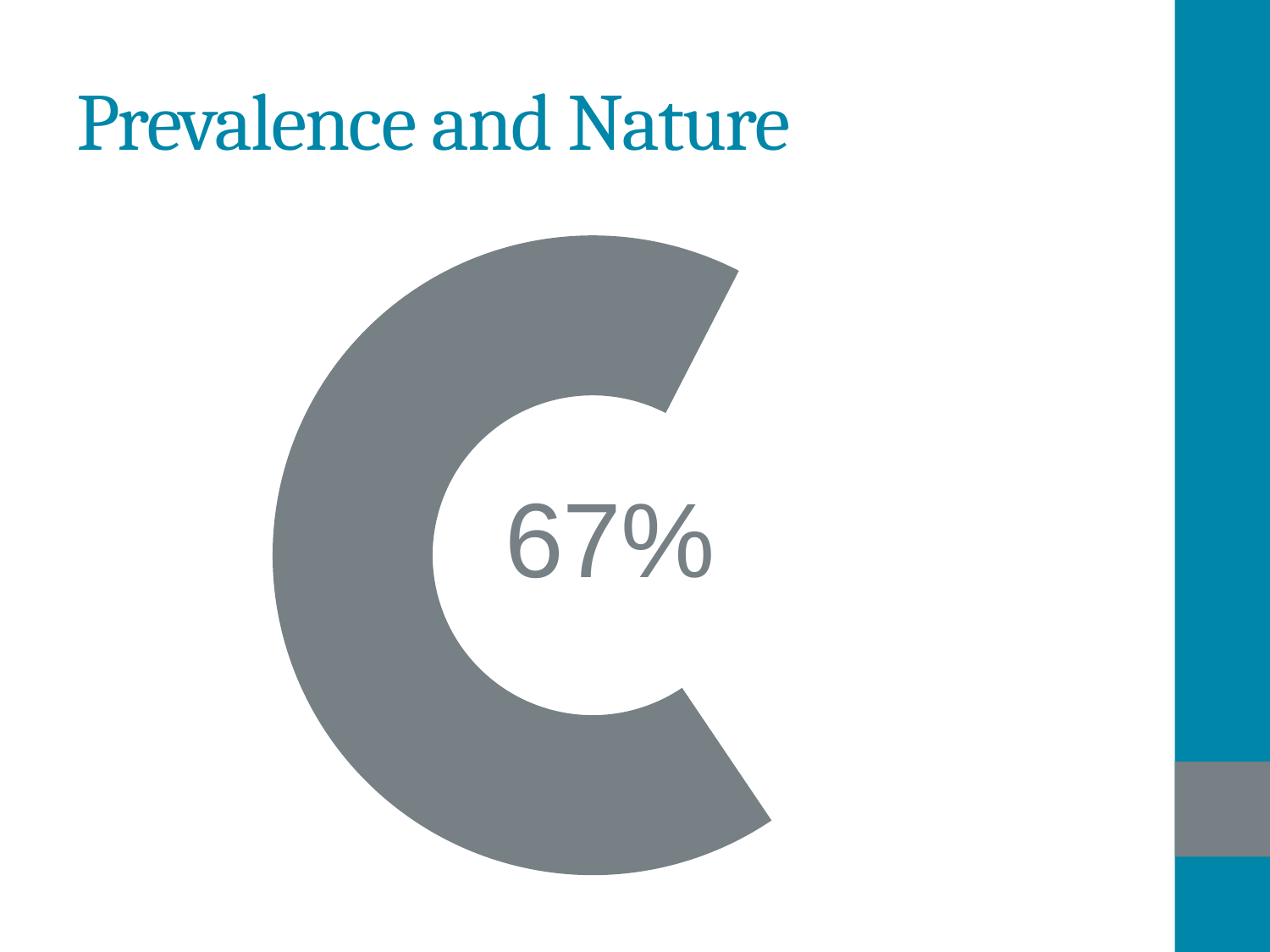
What is the title of the slide containing the doughnut chart? Prevalence and Nature What percentage is printed in the centre of the doughnut chart? 67% What colour is the filled segment of the doughnut chart? Grey What share of the doughnut does the grey segment represent? 67% What kind of chart is shown on the slide? Doughnut chart Is the value shown on the doughnut chart greater or less than 50%? greater